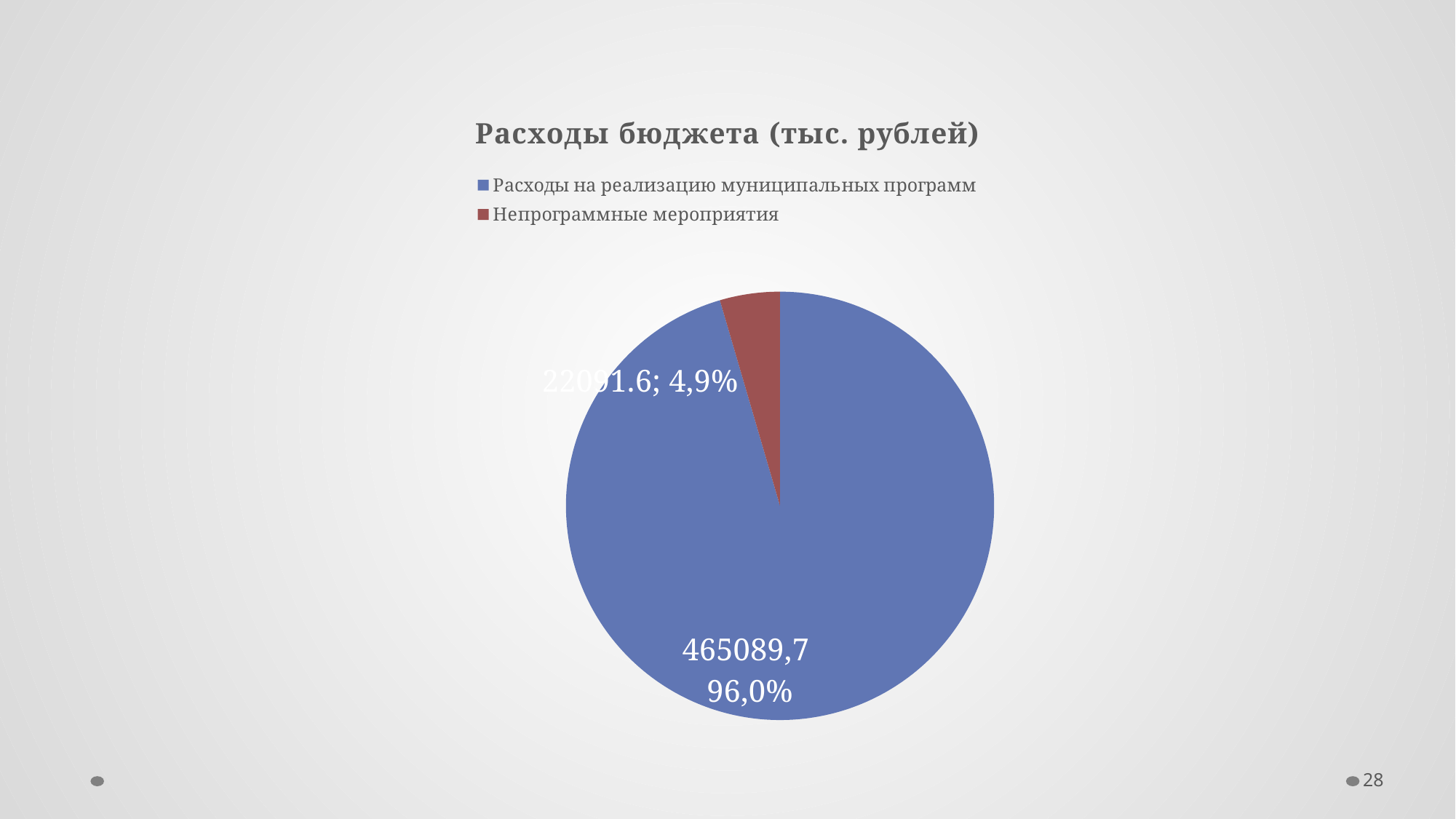
What kind of chart is shown on the slide? pie chart Which is larger, Расходы на реализацию муниципальных программ or Непрограммные мероприятия? Расходы на реализацию муниципальных программ How many entries does the legend list? 2 What is the value for Непрограммные мероприятия? 22091.6 What is the title of the chart? Расходы бюджета (тыс. рублей) Which category has the largest slice? Расходы на реализацию муниципальных программ What colour is the slice for Непрограммные мероприятия? red What share of the pie does Расходы на реализацию муниципальных программ represent? 96,0% What is the value for Расходы на реализацию муниципальных программ? 465089,7 Which category has the smallest slice? Непрограммные мероприятия What share of the pie does Непрограммные мероприятия represent? 4,9% How many slices does the pie chart have? 2